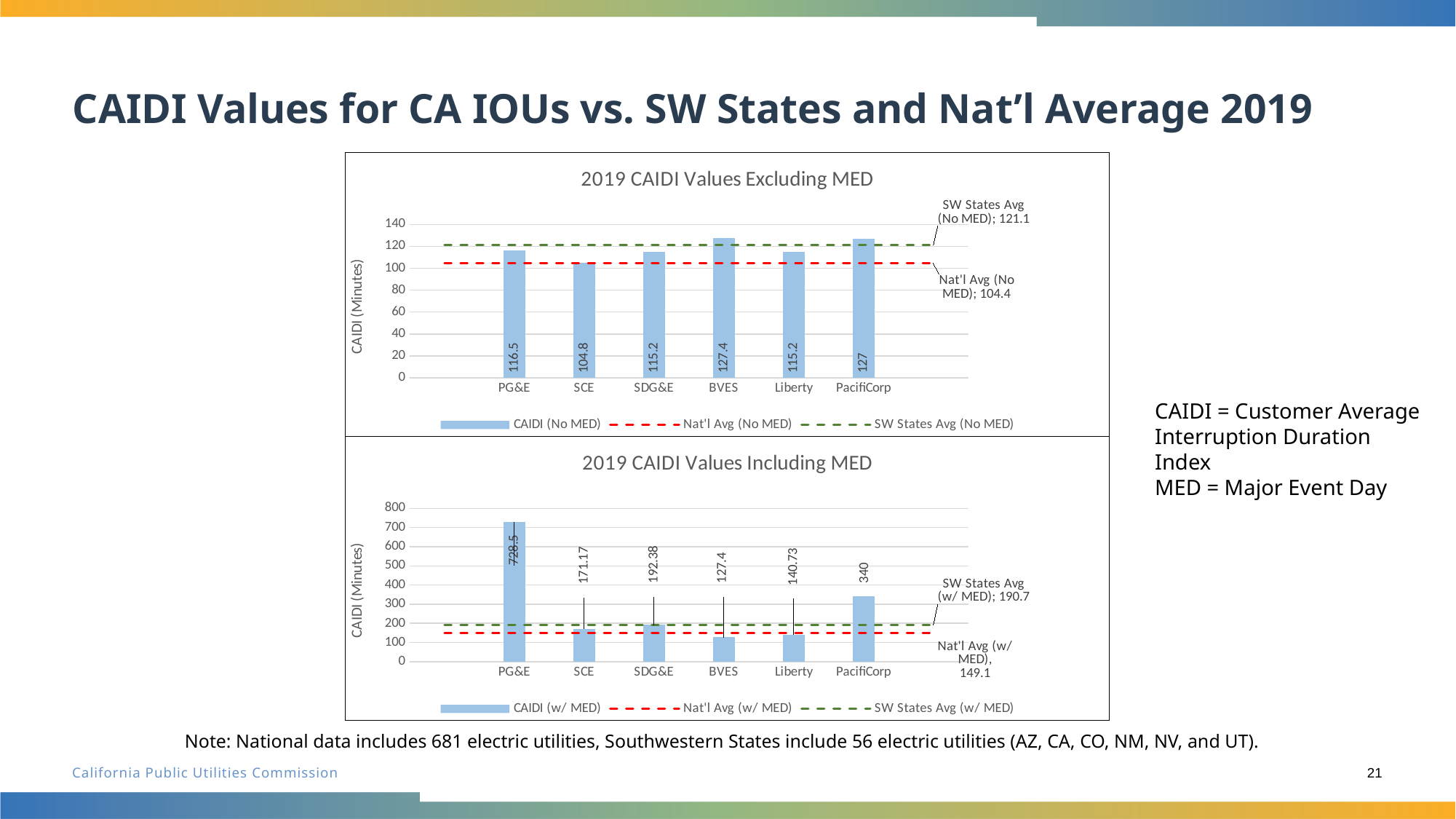
How many series does the legend of the '2019 CAIDI Values Excluding MED' chart list? 3 In the '2019 CAIDI Values Excluding MED' chart, which utility has the lowest CAIDI value? SCE In the '2019 CAIDI Values Including MED' chart, which utility has the lowest CAIDI value? BVES In the '2019 CAIDI Values Including MED' chart, what is the CAIDI value for PacifiCorp? 340 How many utilities are shown on the x axis of the '2019 CAIDI Values Including MED' chart? 6 In the '2019 CAIDI Values Including MED' chart, what is the difference between the CAIDI values for PG&E and PacifiCorp? 388.5 In the '2019 CAIDI Values Including MED' chart, which utility has the highest CAIDI value? PG&E In the '2019 CAIDI Values Excluding MED' chart, what is the SW States Avg (No MED) value? 121.1 What type of chart is the '2019 CAIDI Values Including MED' chart? Combination bar and line chart (bars with dashed average lines) In the '2019 CAIDI Values Excluding MED' chart, what is the CAIDI value for PG&E? 116.5 In the '2019 CAIDI Values Including MED' chart, what is the Nat'l Avg (w/ MED) value? 149.1 In the '2019 CAIDI Values Excluding MED' chart, which is larger: the CAIDI value for SDG&E or for SCE? SDG&E